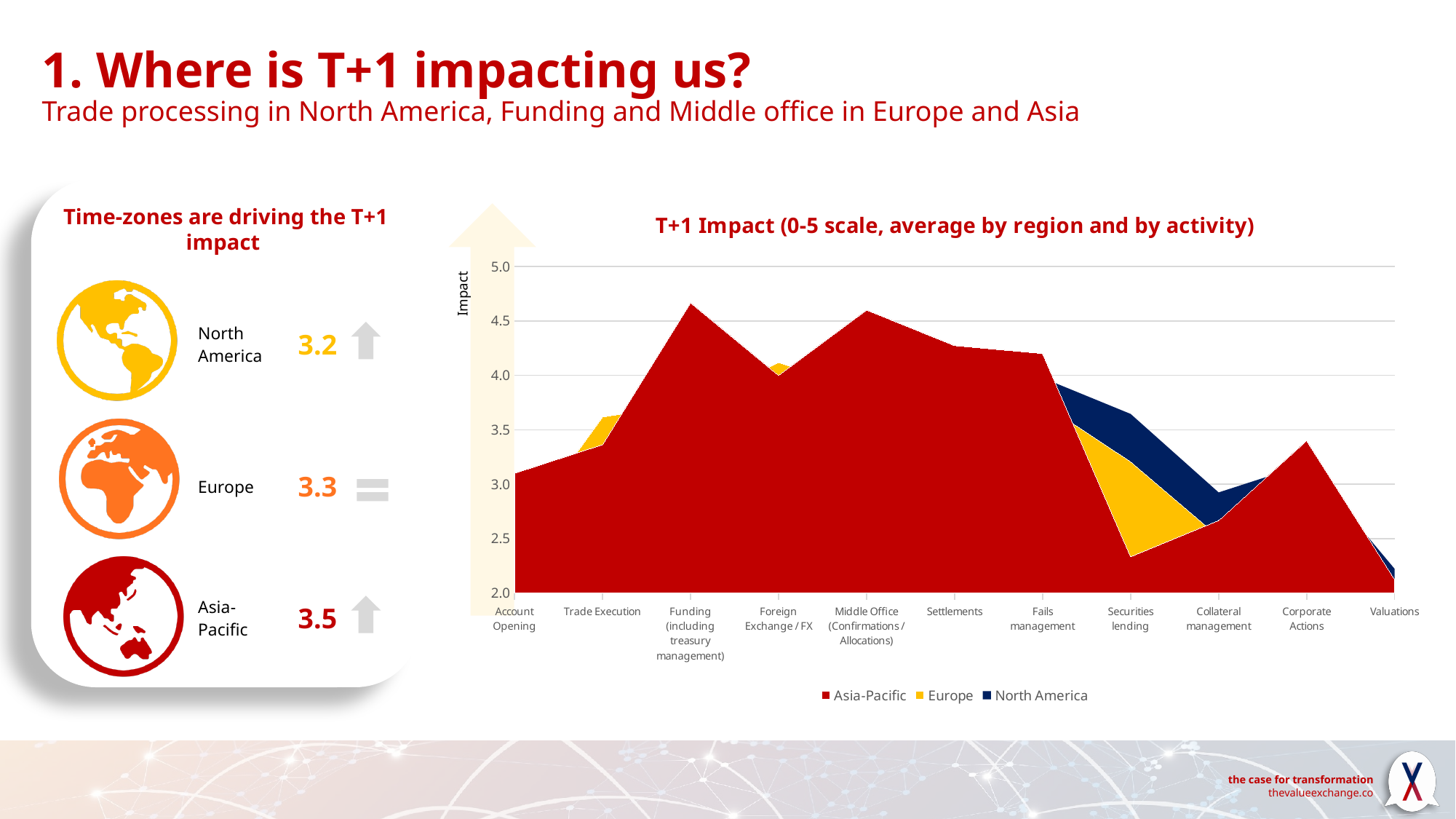
What kind of chart is shown on the slide? Area chart Is the Asia-Pacific value for Securities lending greater or less than 2.5? less Does the Asia-Pacific series rise or fall from Fails management to Securities lending? Fall Is the Asia-Pacific value for Account Opening greater or less than 3.5? less How many series does the legend of the T+1 Impact chart list? 3 Is the Europe value for Securities lending greater or less than 3.0? greater What is the label on the vertical axis of the T+1 Impact chart? Impact At Securities lending, which is larger: the Europe value or the Asia-Pacific value? Europe How many activity categories are shown on the x axis of the T+1 Impact chart? 11 Which series are listed in the legend of the T+1 Impact chart? Asia-Pacific, Europe, North America